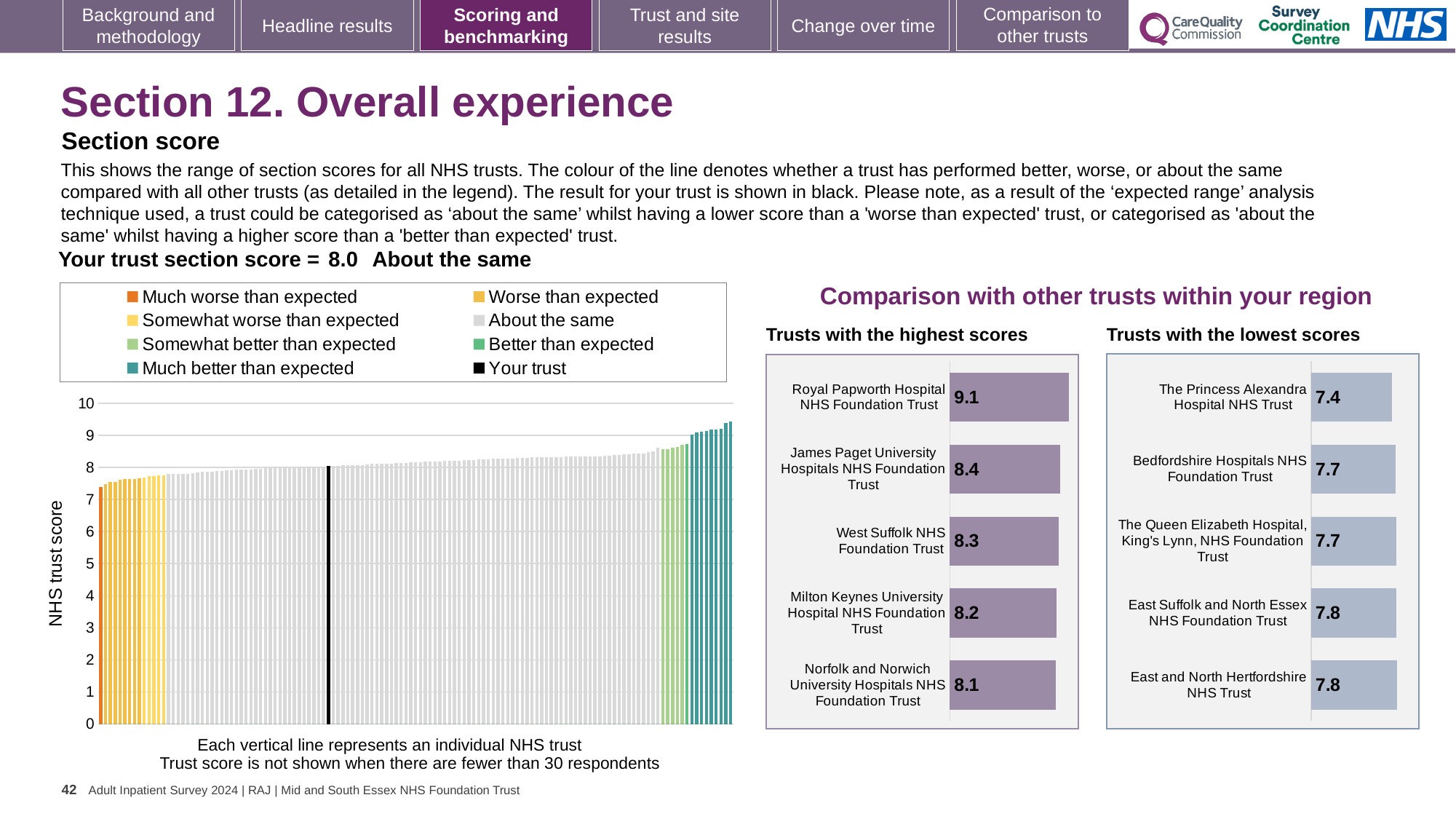
In the 'Trusts with the highest scores' chart, which has the larger score: James Paget University Hospitals NHS Foundation Trust or Milton Keynes University Hospital NHS Foundation Trust? James Paget University Hospitals NHS Foundation Trust In the 'Trusts with the highest scores' chart, which trust has the highest score? Royal Papworth Hospital NHS Foundation Trust In the 'Trusts with the lowest scores' chart, what is the score for The Princess Alexandra Hospital NHS Trust? 7.4 In the main chart on the left, do the trust scores rise or fall from left to right along the x axis? rise How many trusts are shown in the 'Trusts with the lowest scores' chart? 5 How many entries does the legend of the main chart on the left list? 8 In the 'Trusts with the highest scores' chart, what is the score for Royal Papworth Hospital NHS Foundation Trust? 9.1 In the main chart on the left, what is the section score for your trust (the black bar)? 8.0 In the 'Trusts with the lowest scores' chart, what is the score for East Suffolk and North Essex NHS Foundation Trust? 7.8 In the 'Trusts with the lowest scores' chart, which trust has the lowest score? The Princess Alexandra Hospital NHS Trust In the 'Trusts with the highest scores' chart, what is the difference between the scores of Royal Papworth Hospital NHS Foundation Trust and Norfolk and Norwich University Hospitals NHS Foundation Trust? 1.0 In the 'Trusts with the highest scores' chart, what is the score for West Suffolk NHS Foundation Trust? 8.3